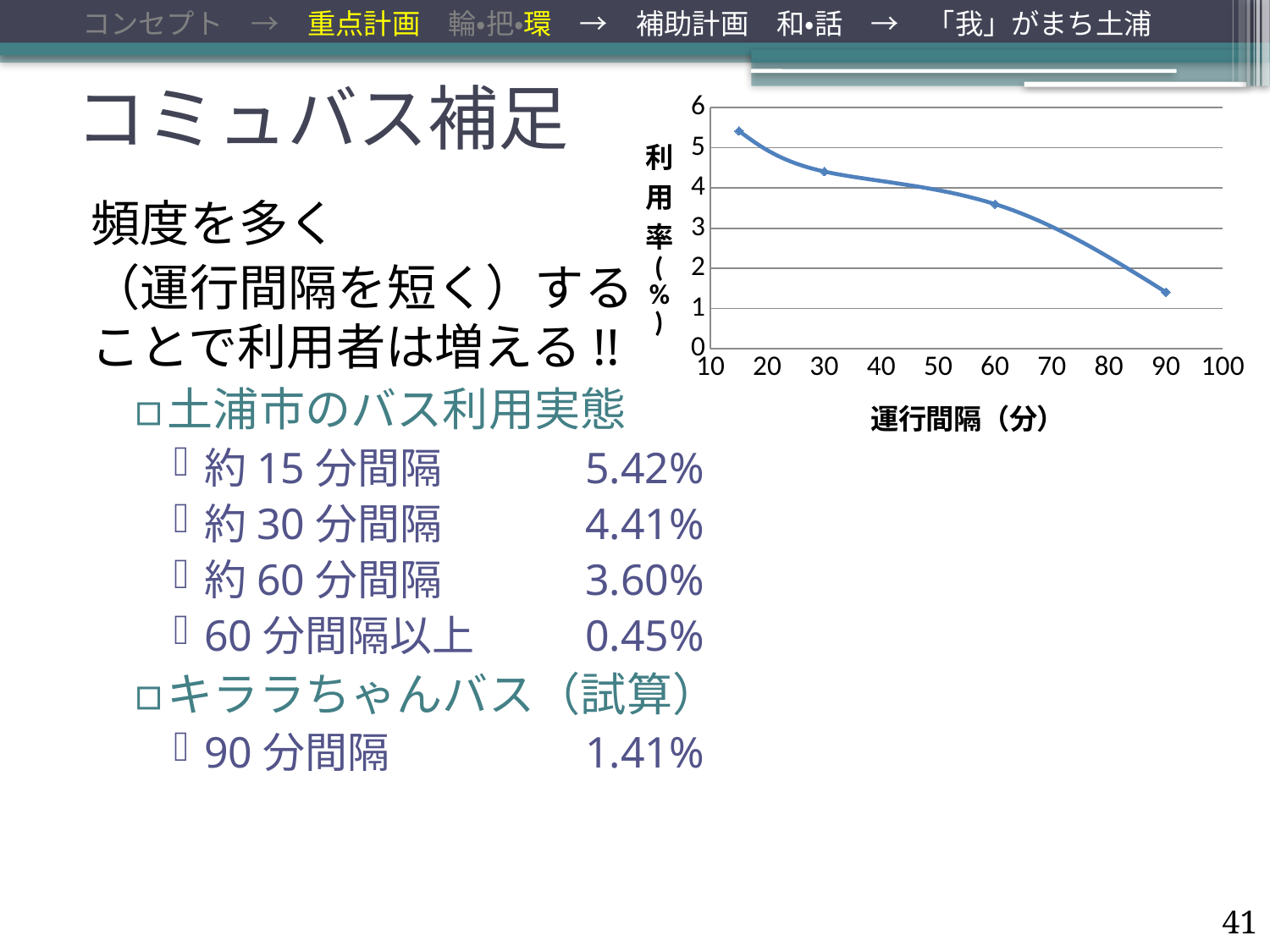
What is the title of the y axis of the chart? 利用率（%） Which has the higher utilization rate: the 30-minute interval or the 60-minute interval? 30-minute interval At which service interval (in minutes) is the utilization rate lowest? 90 What is the title of the x axis of the chart? 運行間隔（分） Is the utilization rate at a 15-minute interval greater or less than 5? greater How many data points are plotted on the line chart? 4 What kind of chart is shown on the slide? line chart Does the utilization rate (利用率) rise or fall as the service interval (運行間隔) increases along the x axis? fall Is the utilization rate at a 30-minute interval greater or less than 4? greater Is the utilization rate at a 90-minute interval greater or less than 2? less At which service interval (in minutes) is the utilization rate highest? 15